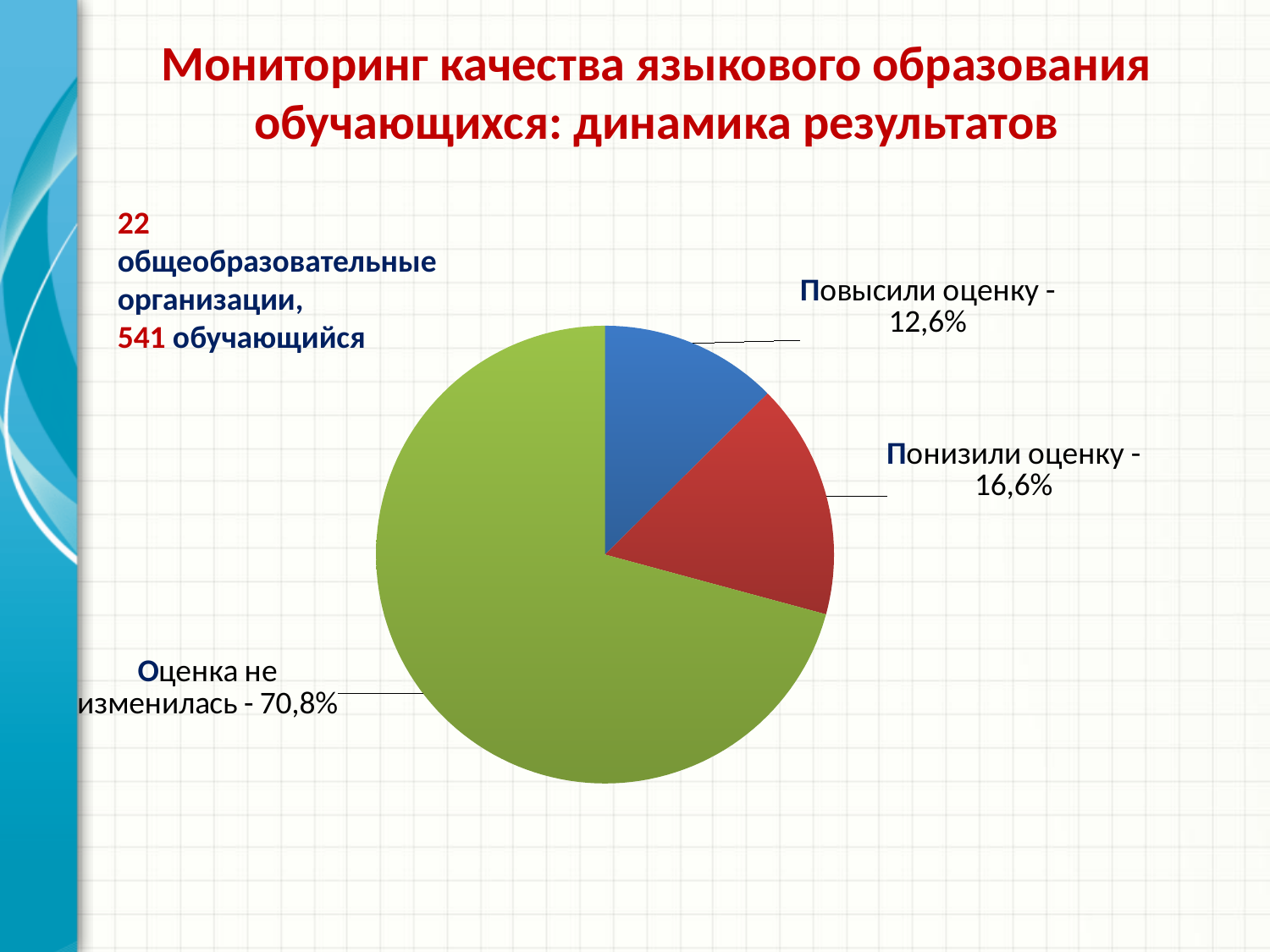
What is the difference between the shares for "Понизили оценку" and "Повысили оценку"? 4,0% What colour is the slice for "Повысили оценку"? blue Which slice of the pie is the largest? Оценка не изменилась What colour is the slice for "Оценка не изменилась"? green What share of the pie is labelled "Повысили оценку"? 12,6% How many slices does the pie chart have? 3 Which is larger: the share for "Понизили оценку" or the share for "Повысили оценку"? Понизили оценку What kind of chart is shown on the slide? pie chart What share of the pie is labelled "Оценка не изменилась"? 70,8% What share of the pie is labelled "Понизили оценку"? 16,6% Which slice of the pie is the smallest? Повысили оценку What is the difference between the shares for "Оценка не изменилась" and "Понизили оценку"? 54,2%